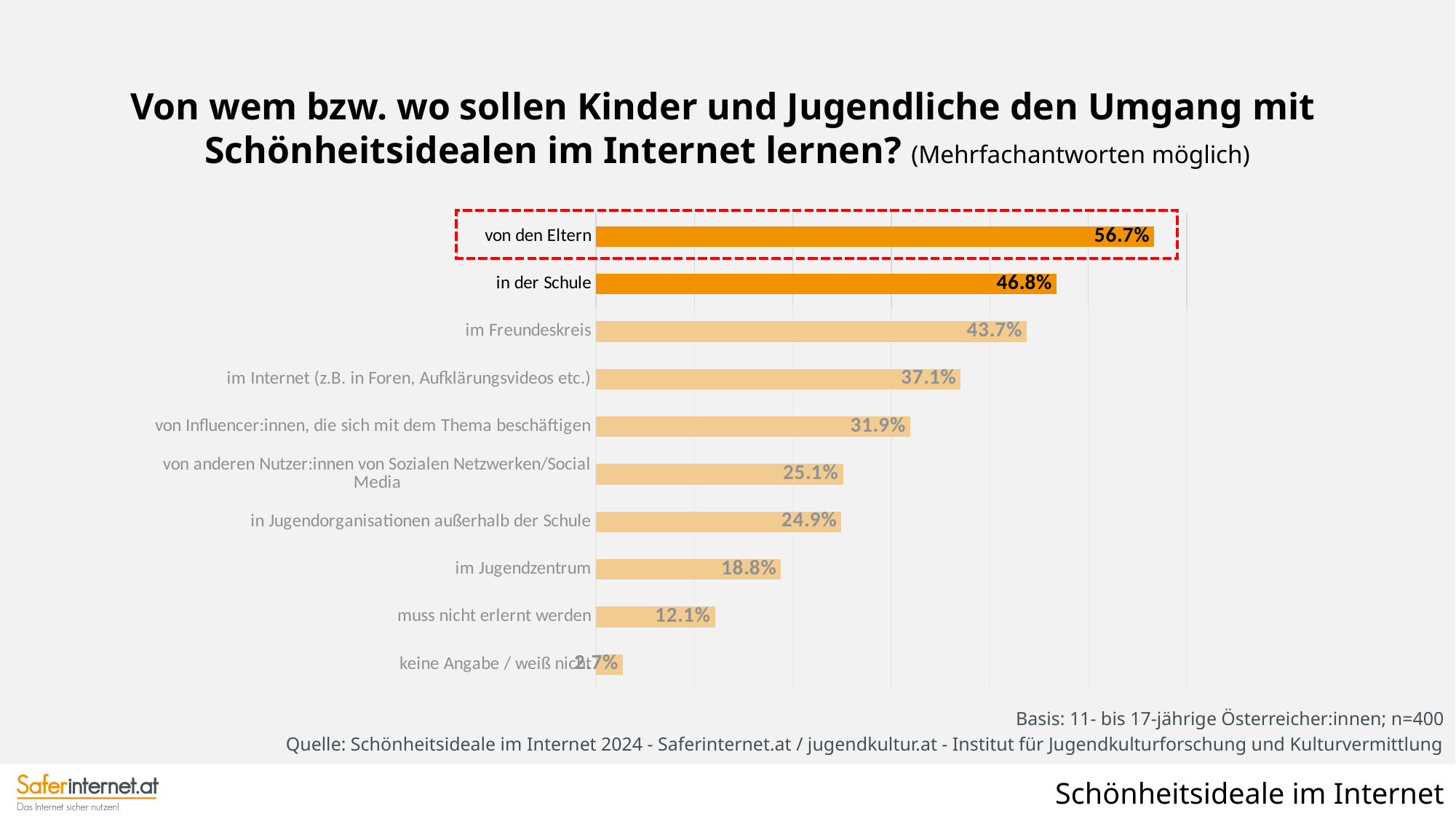
What is the value shown for 'in der Schule'? 46.8% What is the difference in percentage points between 'von den Eltern' and 'in der Schule'? 9.9 percentage points What type of chart is shown on the slide? Bar chart Which two categories are highlighted in a darker orange colour? von den Eltern and in der Schule What is the value for 'von Influencer:innen, die sich mit dem Thema beschäftigen'? 31.9% How many categories are shown in the chart? 10 What percentage is shown for 'muss nicht erlernt werden'? 12.1% What percentage of respondents said children and young people should learn how to deal with beauty ideals on the internet from their parents (von den Eltern)? 56.7% Which category has the highest value in the chart? von den Eltern Which has a higher value: 'im Jugendzentrum' or 'in Jugendorganisationen außerhalb der Schule'? in Jugendorganisationen außerhalb der Schule What is the difference between 'im Internet (z.B. in Foren, Aufklärungsvideos etc.)' and 'im Jugendzentrum'? 18.3 percentage points What percentage is shown for 'im Freundeskreis'? 43.7%